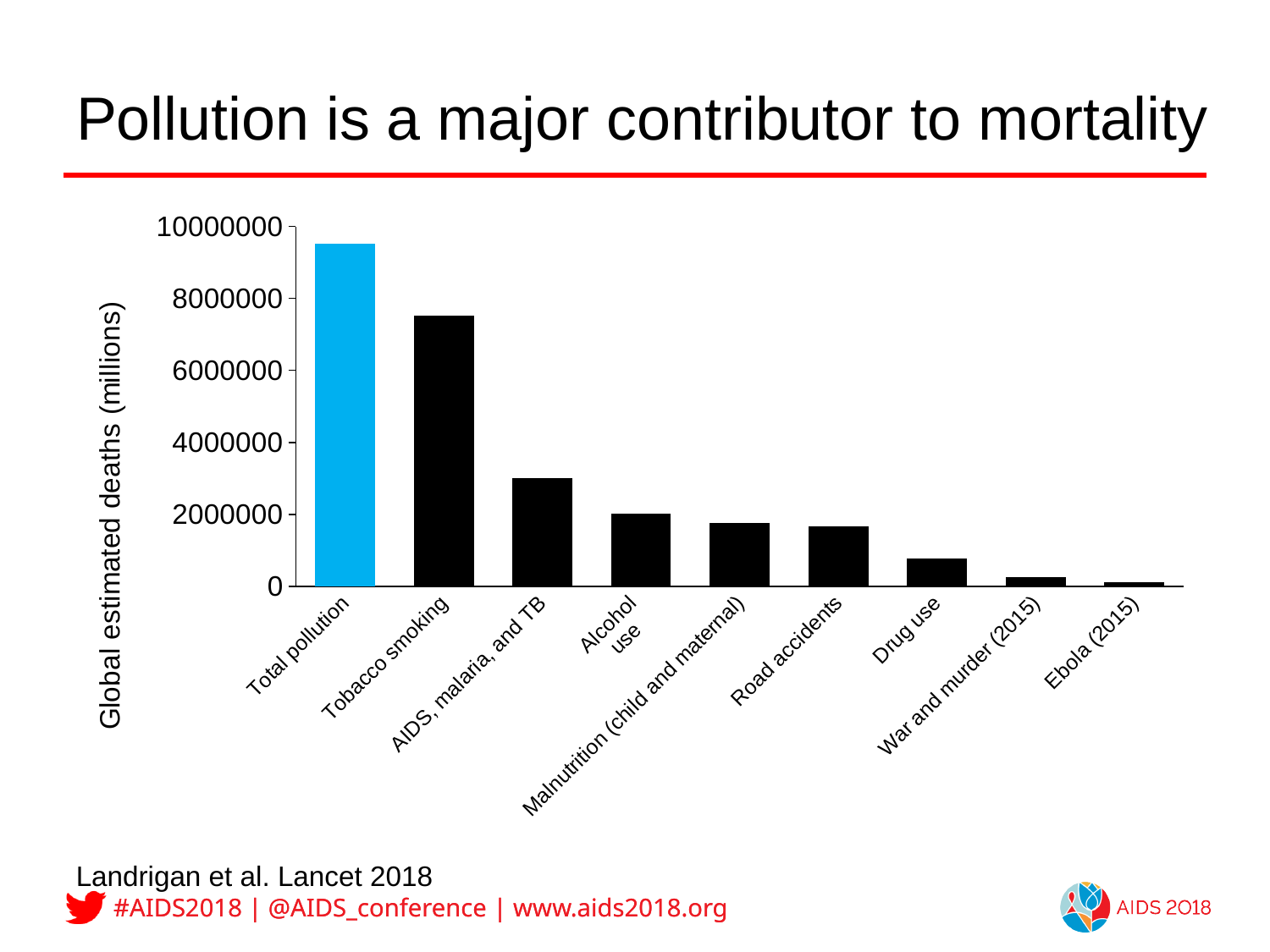
Is the value for Tobacco smoking greater or less than 8000000? less Is the value for AIDS, malaria, and TB greater or less than 4000000? less Which category has the highest number of global estimated deaths? Total pollution What kind of chart is shown on the slide? bar chart What is the title of the y axis? Global estimated deaths (millions) How many categories are plotted on the chart? 9 Is the value for Tobacco smoking greater or less than 6000000? greater Which category has the lowest number of global estimated deaths? Ebola (2015) Do the values rise or fall moving from left to right along the x axis? fall Which is larger, the value for Tobacco smoking or the value for AIDS, malaria, and TB? Tobacco smoking